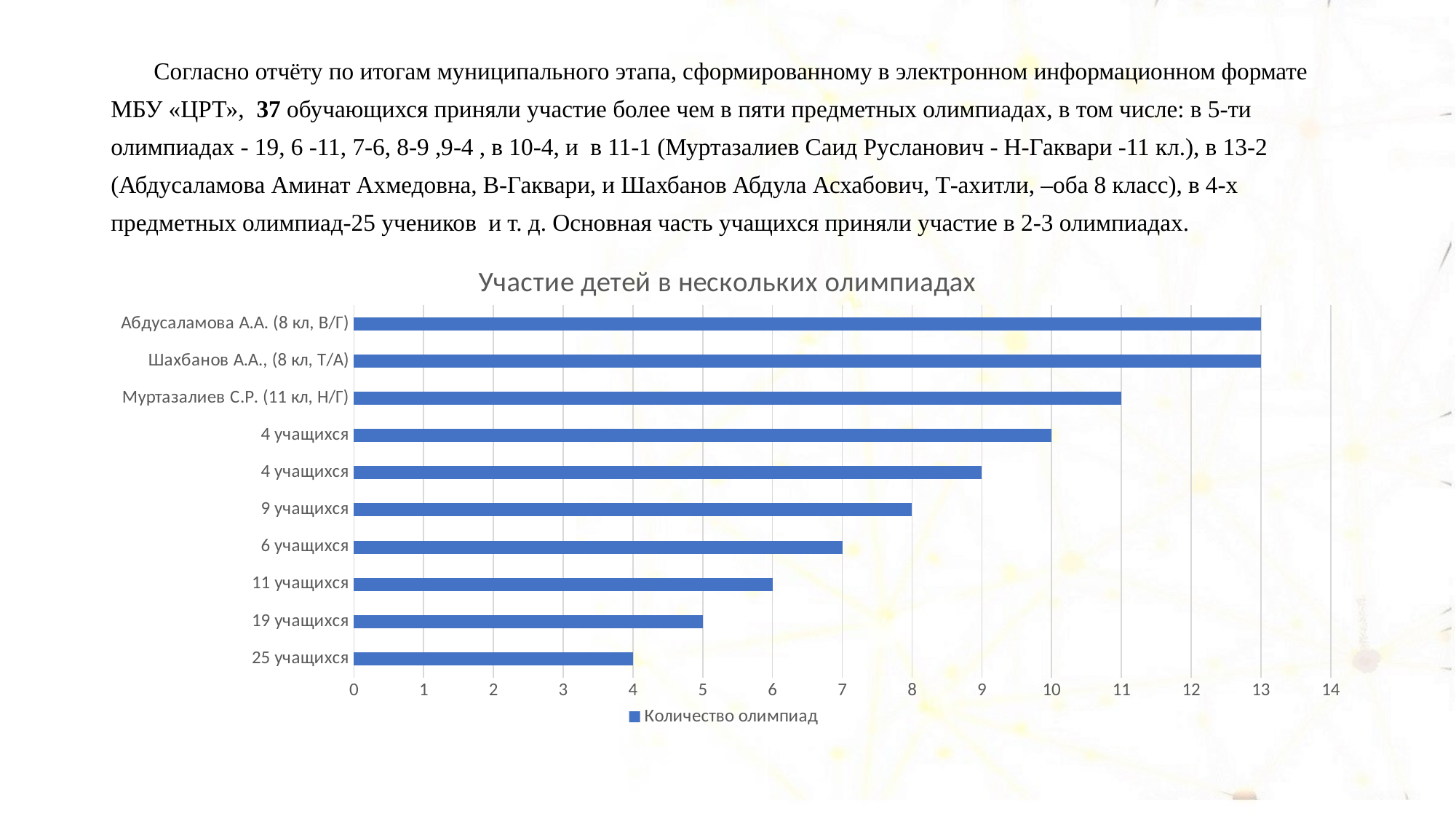
How many series does the legend list? 1 What is the value for 25 учащихся? 4 What kind of chart is shown on the slide? bar chart What is the title of the chart? Участие детей в нескольких олимпиадах What is the difference between the values for Муртазалиев С.Р. (11 кл, Н/Г) and 25 учащихся? 7 What is the value for 19 учащихся? 5 How many categories (bars) does the chart show? 10 What is the value for 9 учащихся? 8 Which is larger, the value for 6 учащихся or the value for 11 учащихся? 6 учащихся Is the value for Шахбанов А.А., (8 кл, Т/А) greater or less than 10? greater Which category has the lowest value? 25 учащихся What is the value for Муртазалиев С.Р. (11 кл, Н/Г)? 11